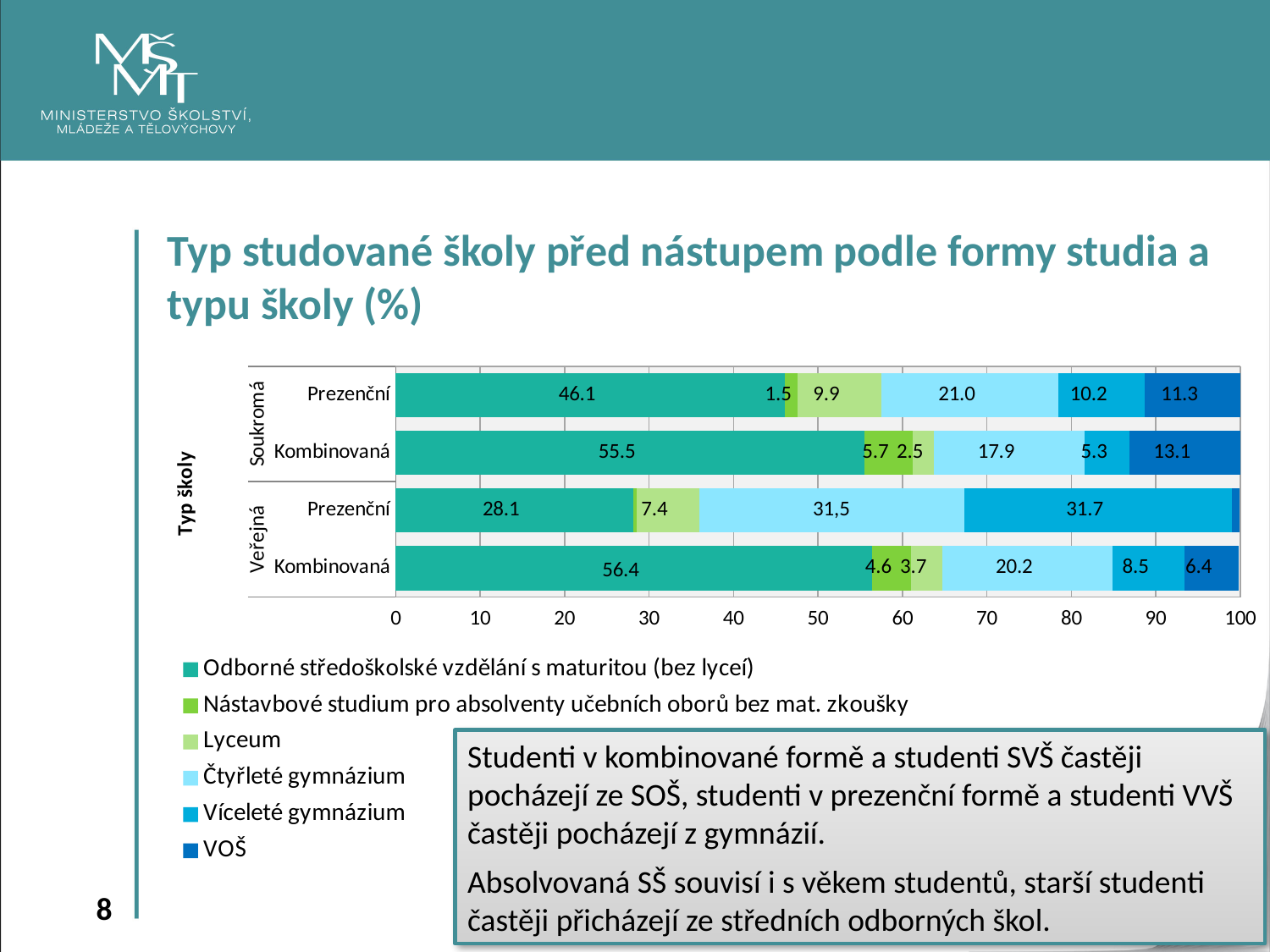
What is the value of 'Víceleté gymnázium' for the Veřejná Prezenční bar? 31.7 What type of chart is shown on the slide? Stacked bar chart What is the value of 'Odborné středoškolské vzdělání s maturitou (bez lyceí)' for the Soukromá Prezenční bar? 46.1 What is the value of 'Čtyřleté gymnázium' for the Veřejná Kombinovaná bar? 20.2 Which bar has the highest value for 'Odborné středoškolské vzdělání s maturitou (bez lyceí)'? Veřejná Kombinovaná Which is larger: the 'VOŠ' value for Soukromá Prezenční or for Veřejná Kombinovaná? Soukromá Prezenční Which bar has the lowest value for 'Odborné středoškolské vzdělání s maturitou (bez lyceí)'? Veřejná Prezenční What is the difference between the 'Odborné středoškolské vzdělání s maturitou (bez lyceí)' values for Soukromá Kombinovaná and Soukromá Prezenční? 9.4 How many series does the legend list? 6 What is the title of the chart on the slide? Typ studované školy před nástupem podle formy studia a typu školy (%) What is the value of 'VOŠ' for the Soukromá Kombinovaná bar? 13.1 How many bars (form-of-study categories) are plotted in the chart? 4